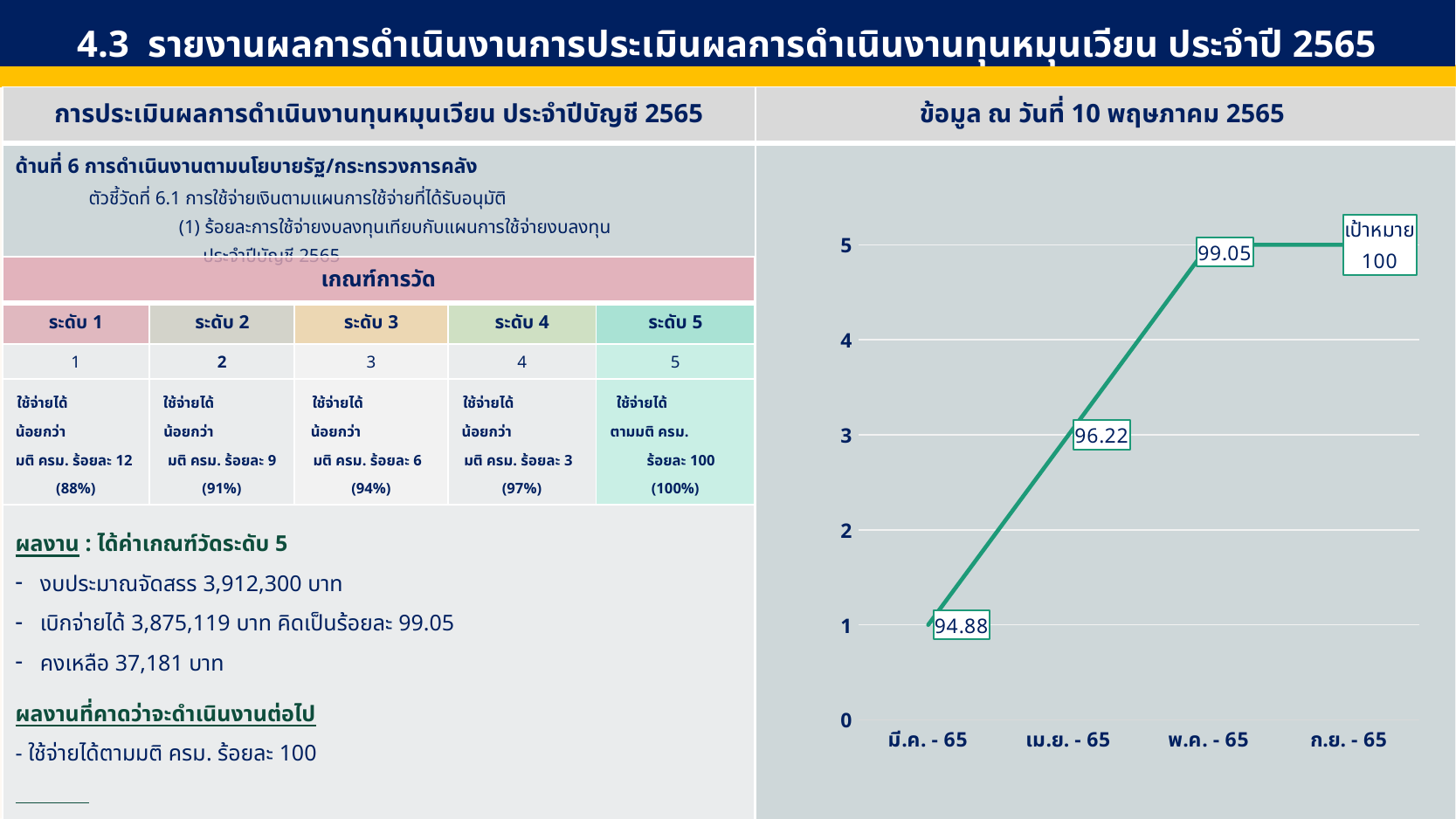
Which is larger, the labelled value for เม.ย. - 65 or for พ.ค. - 65? พ.ค. - 65 What target value (เป้าหมาย) is shown at ก.ย. - 65 in the line chart? 100 What is the difference between the labelled values for เม.ย. - 65 and มี.ค. - 65? 1.34 What is the data label for เม.ย. - 65 in the line chart? 96.22 On the y-axis scale of the line chart, is the point for เม.ย. - 65 greater or less than 2? greater What is the data label for มี.ค. - 65 in the line chart? 94.88 What is the difference between the labelled values for พ.ค. - 65 and มี.ค. - 65? 4.17 What is the data label for พ.ค. - 65 in the line chart? 99.05 What type of chart is shown on the right side of the slide? line chart Which month has the lowest labelled value in the line chart? มี.ค. - 65 Do the values in the line chart rise or fall from มี.ค. - 65 to พ.ค. - 65? rise How many categories are shown on the x axis of the line chart? 4